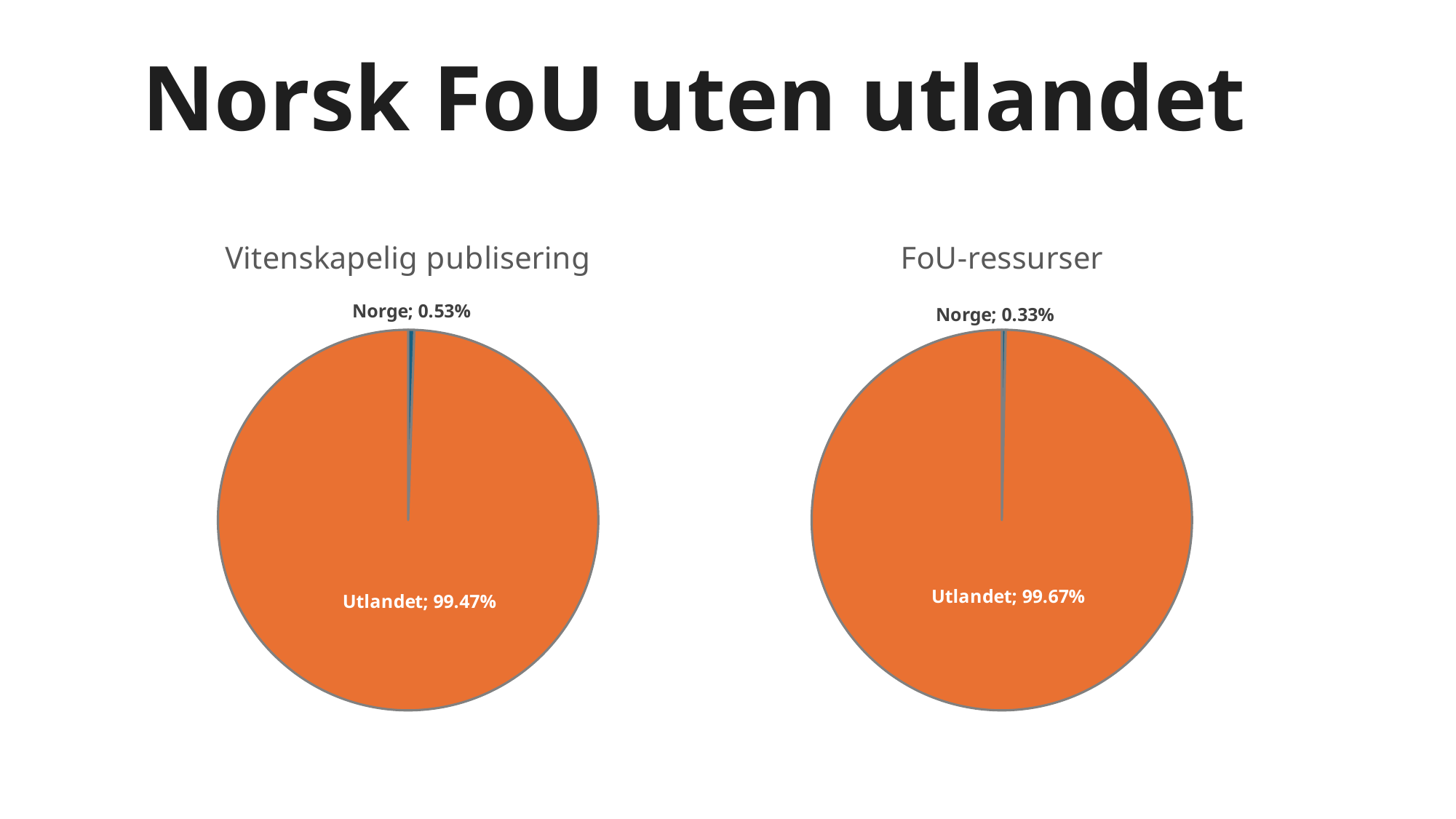
In the 'Vitenskapelig publisering' chart, what is the value for Utlandet? 99.47% How many categories does the 'Vitenskapelig publisering' chart show? 2 In the 'Vitenskapelig publisering' chart, what is the value for Norge? 0.53% In the 'Vitenskapelig publisering' chart, which category has the largest slice? Utlandet In the 'FoU-ressurser' chart, what is the value for Norge? 0.33% In the 'Vitenskapelig publisering' chart, what is the difference between the Utlandet and Norge values? 98.94% What kind of chart is the 'FoU-ressurser' chart? Pie chart In the 'FoU-ressurser' chart, which category has the smallest slice? Norge In the 'FoU-ressurser' chart, what is the difference between the Utlandet and Norge values? 99.34% What is the title of the chart on the right side of the slide? FoU-ressurser Which chart shows a larger value for Norge, 'Vitenskapelig publisering' or 'FoU-ressurser'? Vitenskapelig publisering In the 'FoU-ressurser' chart, what is the value for Utlandet? 99.67%